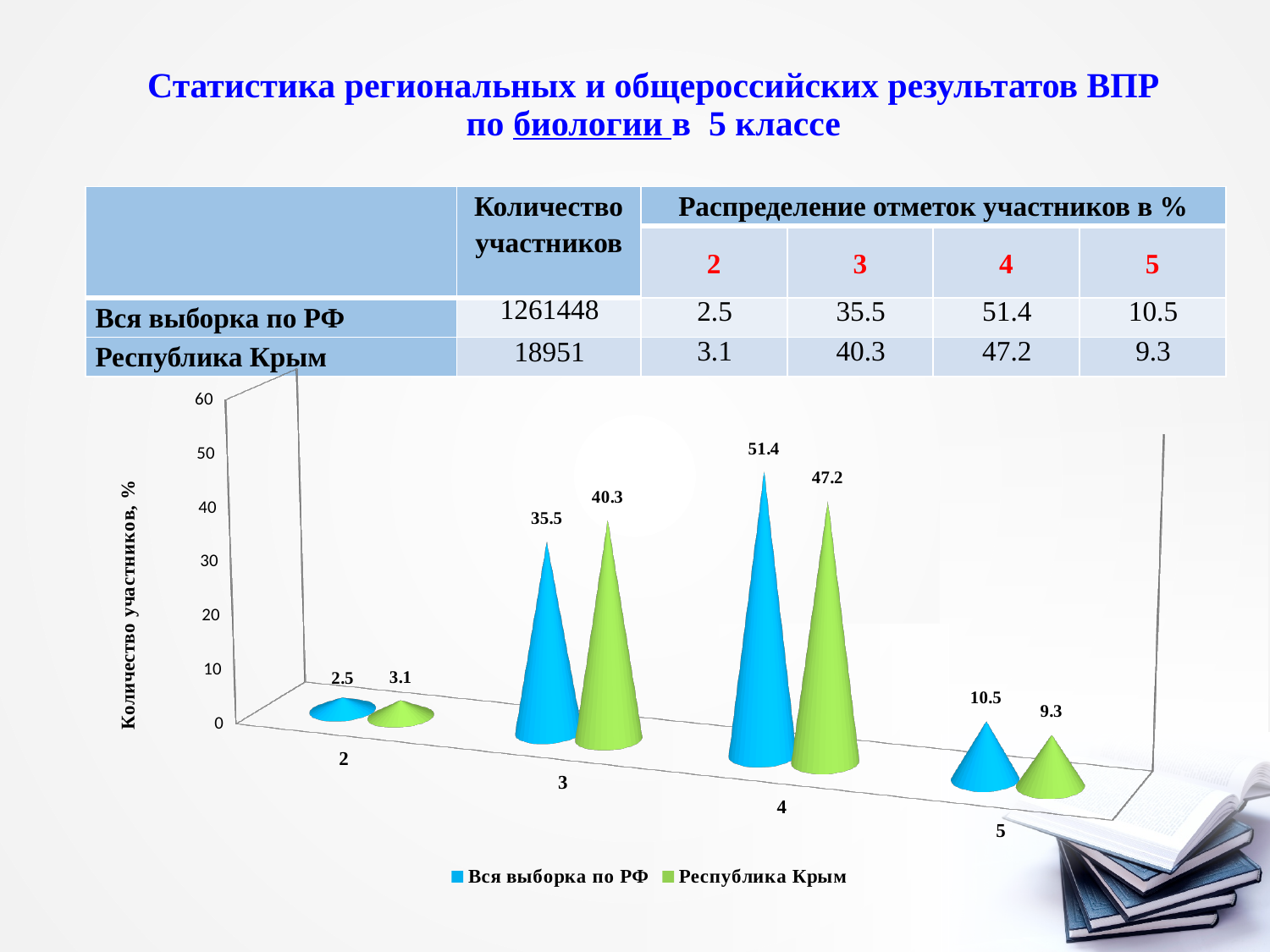
What is the value for "Республика Крым" at mark 5? 9.3 What is the value for "Республика Крым" at mark 3? 40.3 Which colour represents "Республика Крым" in the chart? green Which mark has the lowest value for "Республика Крым"? 2 What is the label of the vertical axis of the chart? Количество участников, % What is the difference between "Республика Крым" and "Вся выборка по РФ" at mark 3? 4.8 Which mark has the highest value for "Вся выборка по РФ"? 4 What is the value for "Вся выборка по РФ" at mark 4? 51.4 At mark 5, which series has the larger value: "Вся выборка по РФ" or "Республика Крым"? Вся выборка по РФ What kind of chart is shown on the slide? bar chart How many series does the chart legend list? 2 How many mark categories are shown on the x axis of the chart? 4